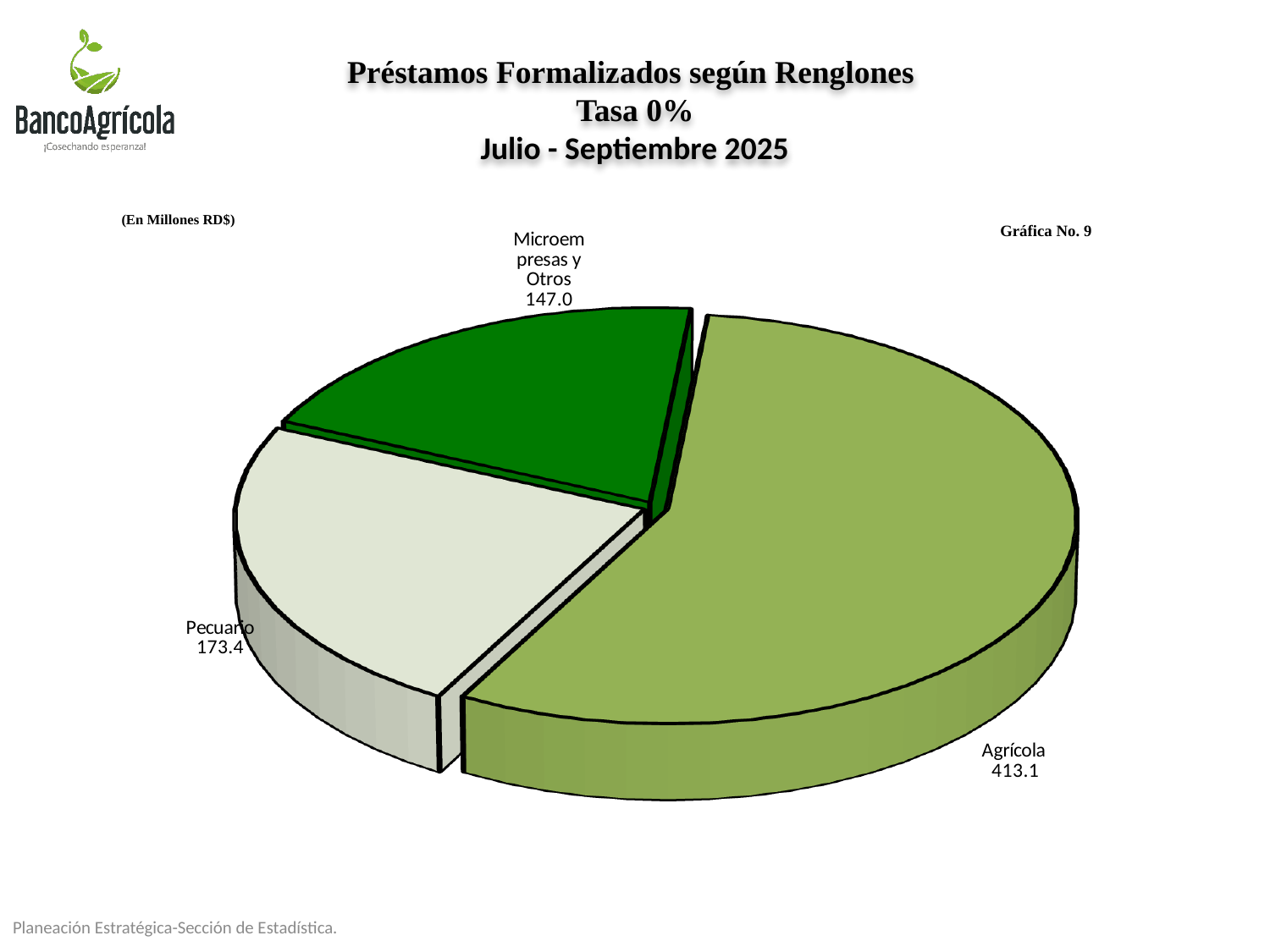
What is the value for Pecuario? 173.4 What is the total of all the slices in the pie chart? 733.5 What is the value for Agrícola? 413.1 How many categories are shown in the pie chart? 3 What is the value for Microempresas y Otros? 147.0 What is the difference between the values for Agrícola and Pecuario? 239.7 What is the difference between the values for Pecuario and Microempresas y Otros? 26.4 In what units are the values in the chart expressed? En Millones RD$ Which category has the smallest slice of the pie? Microempresas y Otros Which is larger, the value for Pecuario or the value for Microempresas y Otros? Pecuario Which category has the largest slice of the pie? Agrícola What kind of chart is shown on the slide? Pie chart